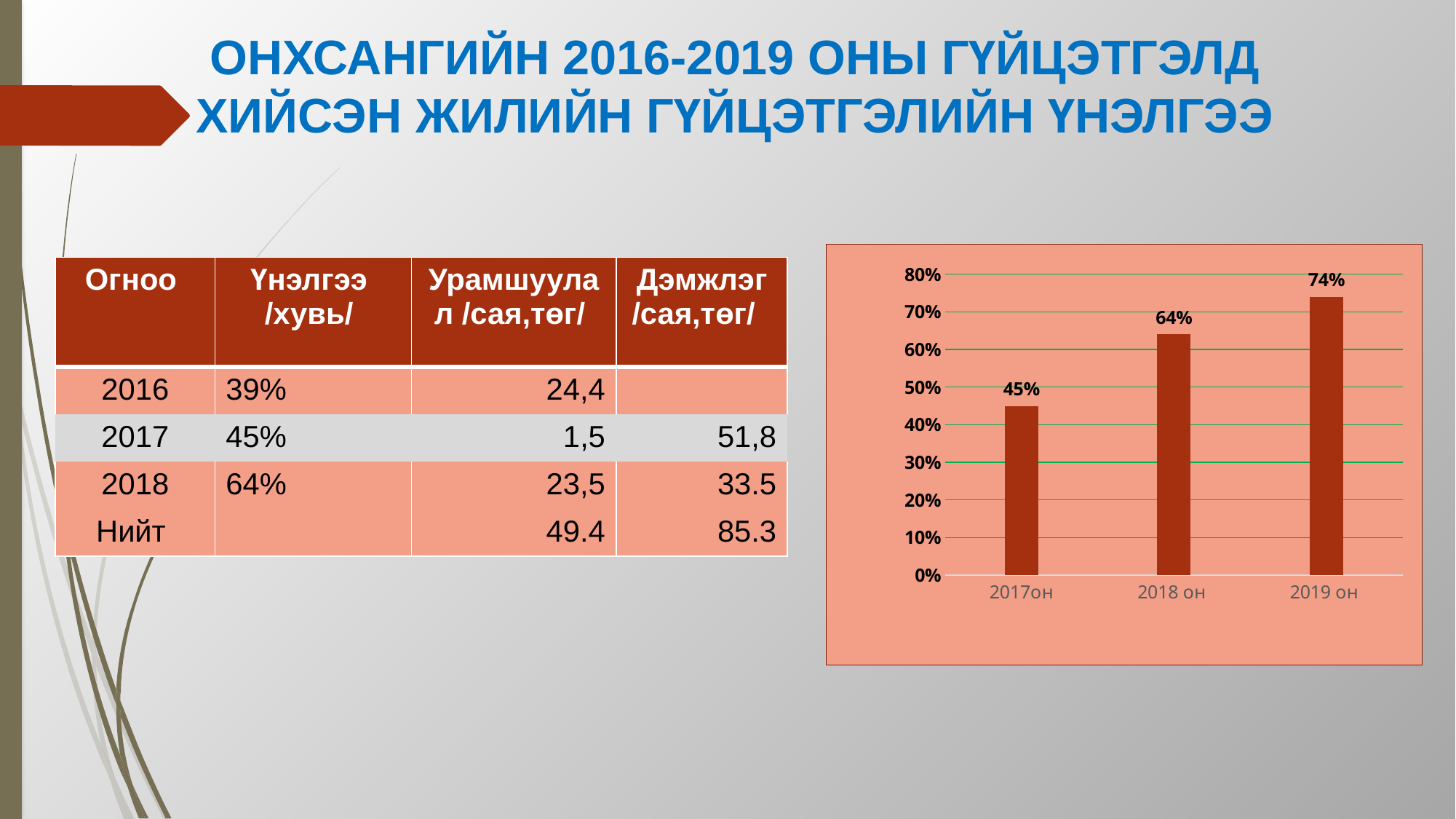
What is the value for 2019 он in the bar chart? 74% Do the values in the bar chart rise or fall from 2017он to 2019 он? rise Which year has the lowest value in the bar chart? 2017он Is the value for 2019 он in the bar chart greater or less than 70%? greater How many bars are shown in the bar chart? 3 Which is larger in the bar chart, the value for 2017он or the value for 2018 он? 2018 он Which year has the highest value in the bar chart? 2019 он What kind of chart is shown on the right of the slide? bar chart What is the value for 2018 он in the bar chart? 64% What is the difference between the values for 2019 он and 2018 он in the bar chart? 10% What is the value for 2017он in the bar chart? 45% What is the difference between the values for 2018 он and 2017он in the bar chart? 19%